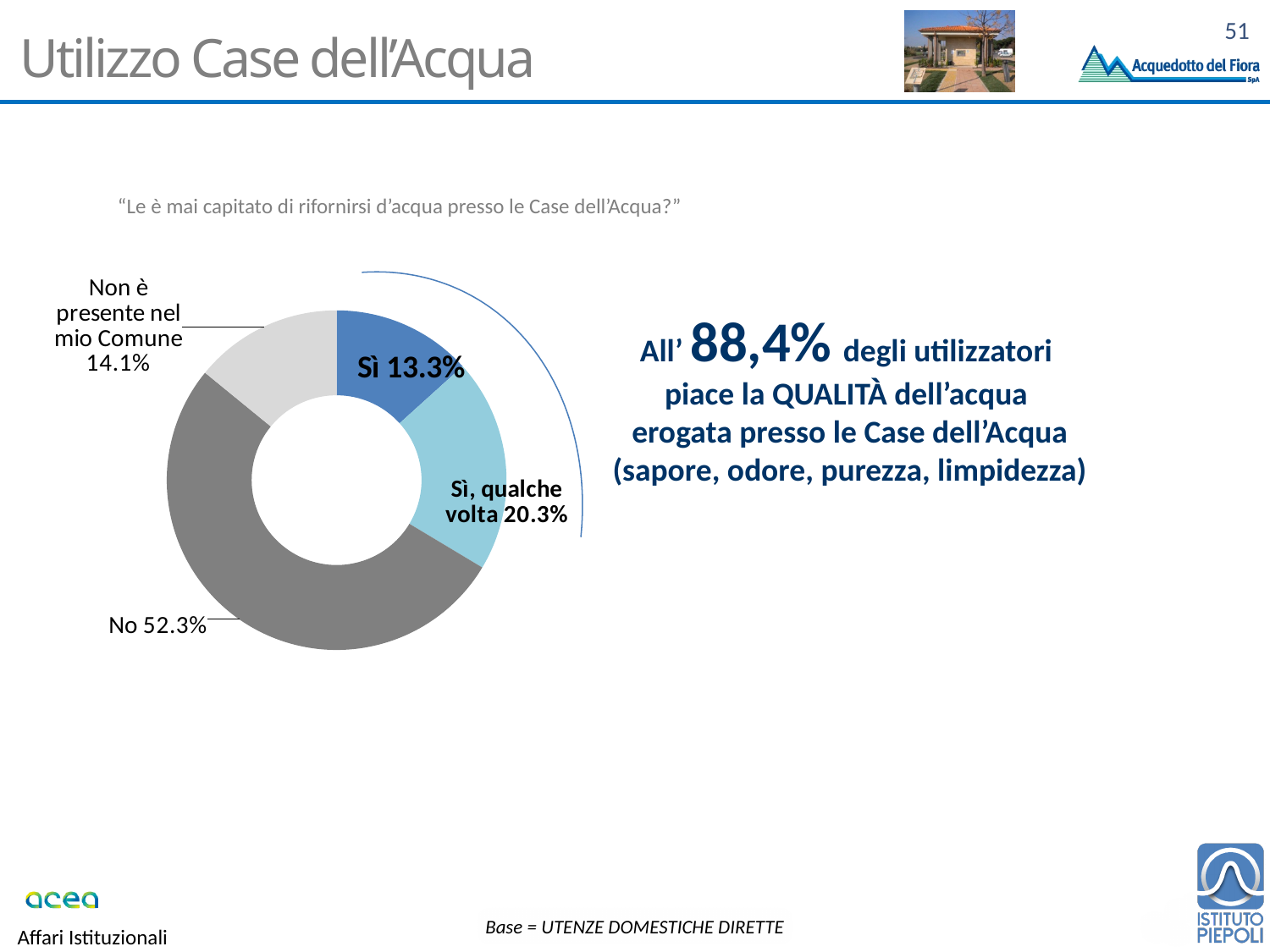
What colour is the "No" slice of the chart? Grey What kind of chart is shown on the slide? Pie chart (doughnut) What percentage of respondents answered "No"? 52.3% How many response categories are shown in the chart? 4 What percentage of respondents answered "Sì, qualche volta"? 20.3% Which is larger: the share for "Sì, qualche volta" or the share for "Non è presente nel mio Comune"? Sì, qualche volta What is the difference in percentage points between "No" and "Sì, qualche volta"? 32 percentage points What is the combined share of "Sì" and "Sì, qualche volta"? 33.6% Which response has the largest share of the chart? No Which response has the smallest share of the chart? Sì What percentage of respondents answered "Sì"? 13.3% What percentage of respondents answered "Non è presente nel mio Comune"? 14.1%